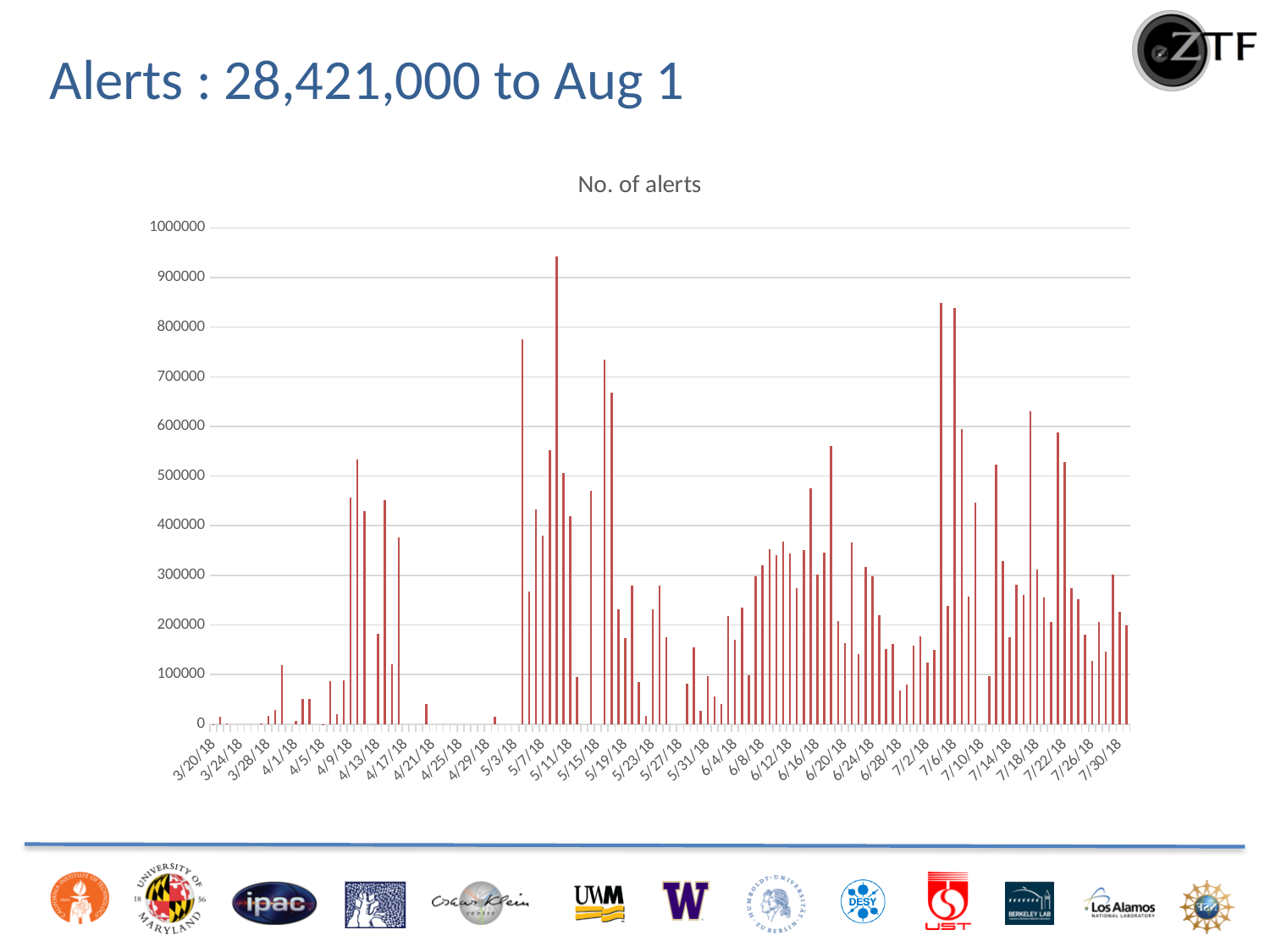
Is the value for 3/20/18 greater or less than 100000? less What is the first date label on the x axis of the chart? 3/20/18 Is the value for 6/12/18 greater or less than 100000? greater Is the value for 7/30/18 greater or less than 400000? less What kind of chart is shown on the slide? bar chart What is the title of the chart? No. of alerts